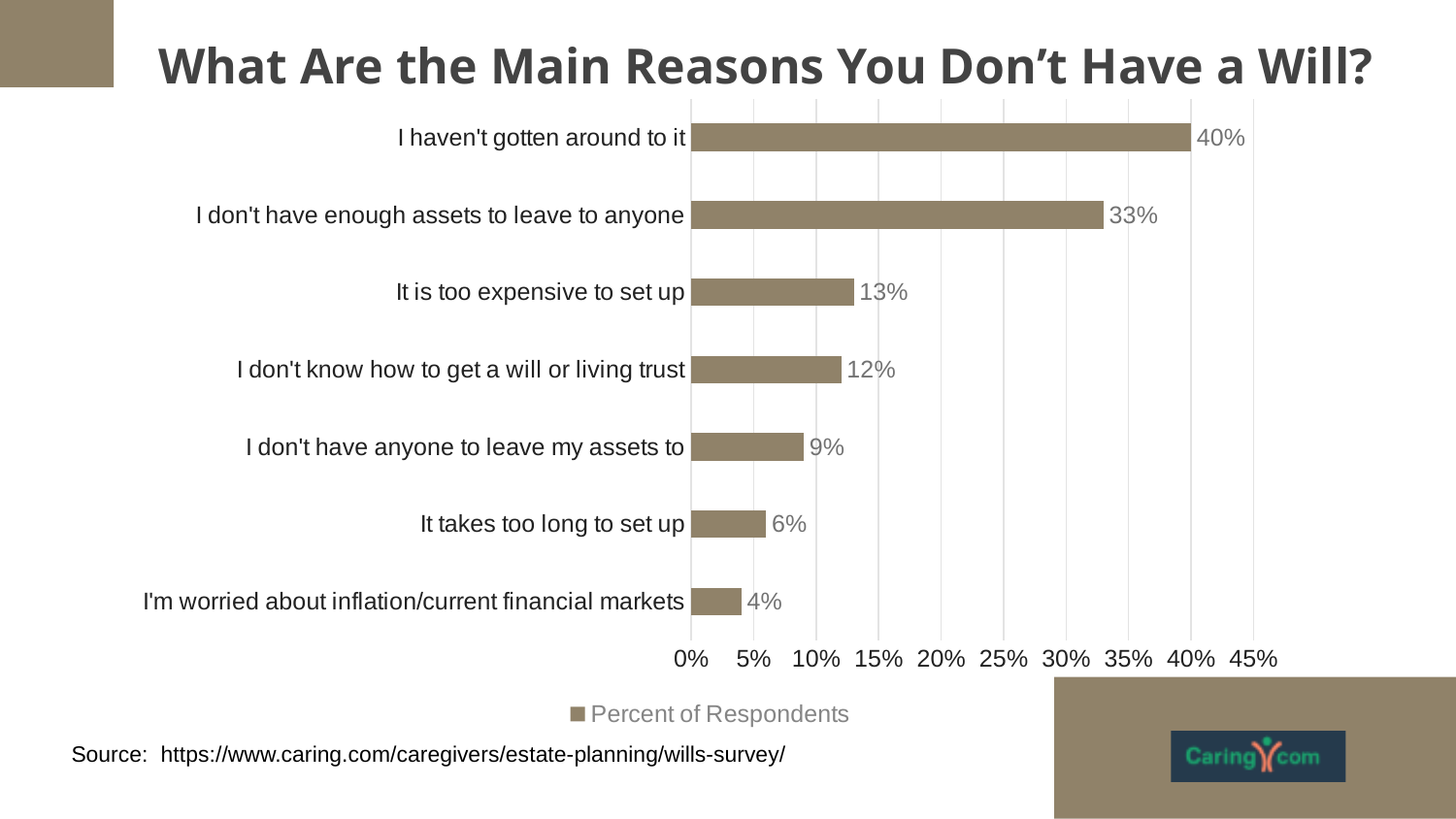
What percentage of respondents said "I haven't gotten around to it"? 40% How many series does the legend list? 1 How many reasons are shown in the chart? 7 Is the value for "I don't have enough assets to leave to anyone" greater or less than 30%? greater Which reason has the highest percentage of respondents? I haven't gotten around to it What percentage of respondents said "I'm worried about inflation/current financial markets"? 4% What is the difference between "I haven't gotten around to it" and "I don't have enough assets to leave to anyone"? 7% What is the legend entry for the series in the chart? Percent of Respondents Which is larger: "I don't have anyone to leave my assets to" or "It takes too long to set up"? I don't have anyone to leave my assets to Which reason has the lowest percentage of respondents? I'm worried about inflation/current financial markets What is the value for "It is too expensive to set up"? 13% What kind of chart is shown on the slide? Bar chart